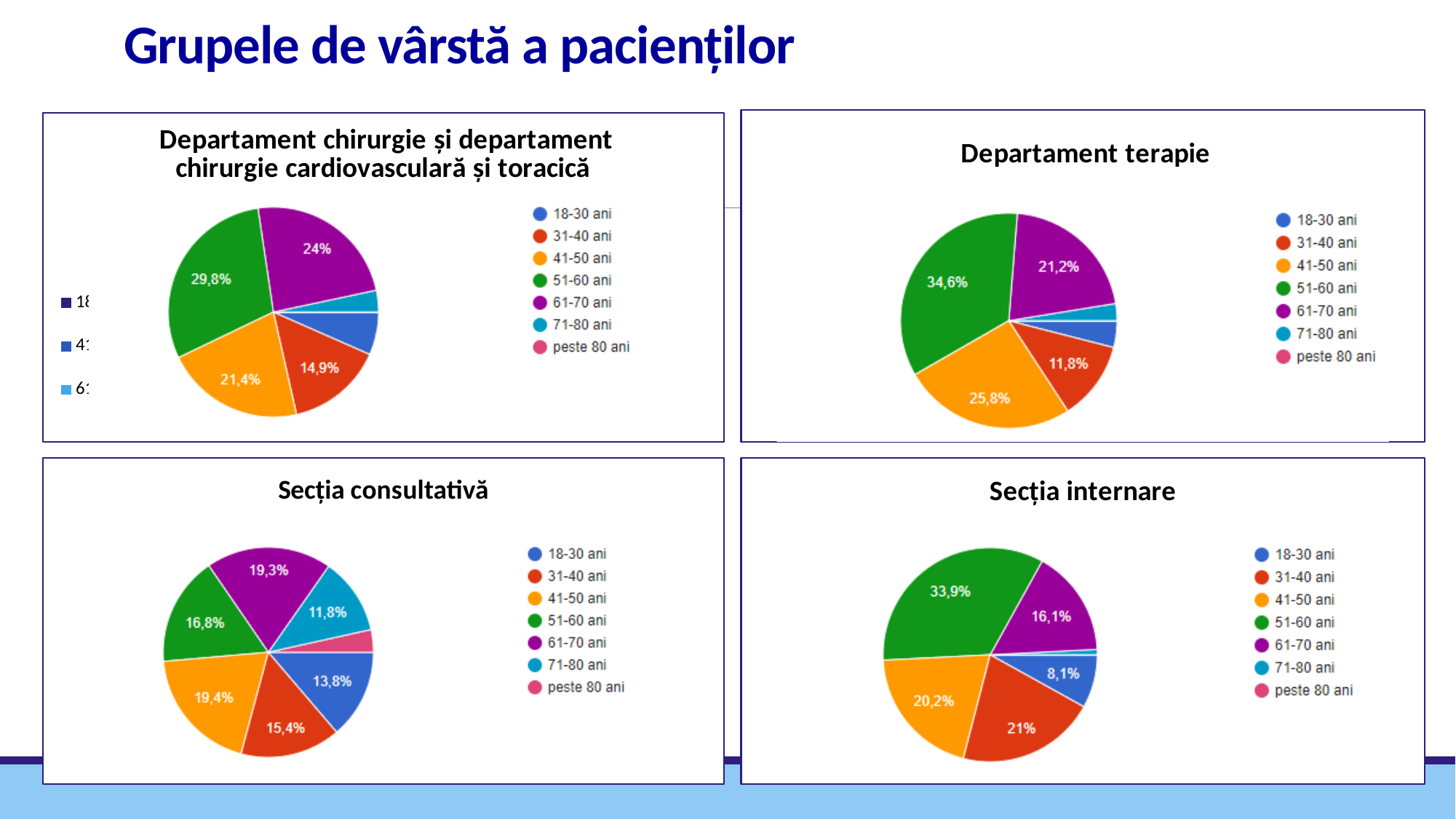
In the 'Secția internare' chart, what share of patients is in the 31-40 ani group? 21% In the 'Departament terapie' chart, what is the difference between the shares for 51-60 ani and 31-40 ani? 22,8% What kind of chart is used in the 'Secția consultativă' panel? Pie chart In the 'Secția consultativă' chart, what share of patients is in the 71-80 ani group? 11,8% In the 'Departament chirurgie și departament chirurgie cardiovasculară și toracică' chart, what share of patients is in the 41-50 ani group? 21,4% In the 'Secția internare' chart, which age group has the largest share? 51-60 ani How many pie charts are shown on the slide? 4 How many age groups does the legend of the 'Departament terapie' chart list? 7 In the 'Departament terapie' chart, which is larger: the share for 41-50 ani or the share for 61-70 ani? 41-50 ani In the 'Departament terapie' chart, what share of patients is in the 51-60 ani group? 34,6% In the 'Secția internare' chart, what is the difference between the shares for 51-60 ani and 61-70 ani? 17,8% In the 'Departament chirurgie și departament chirurgie cardiovasculară și toracică' chart, which age group has the largest share? 51-60 ani